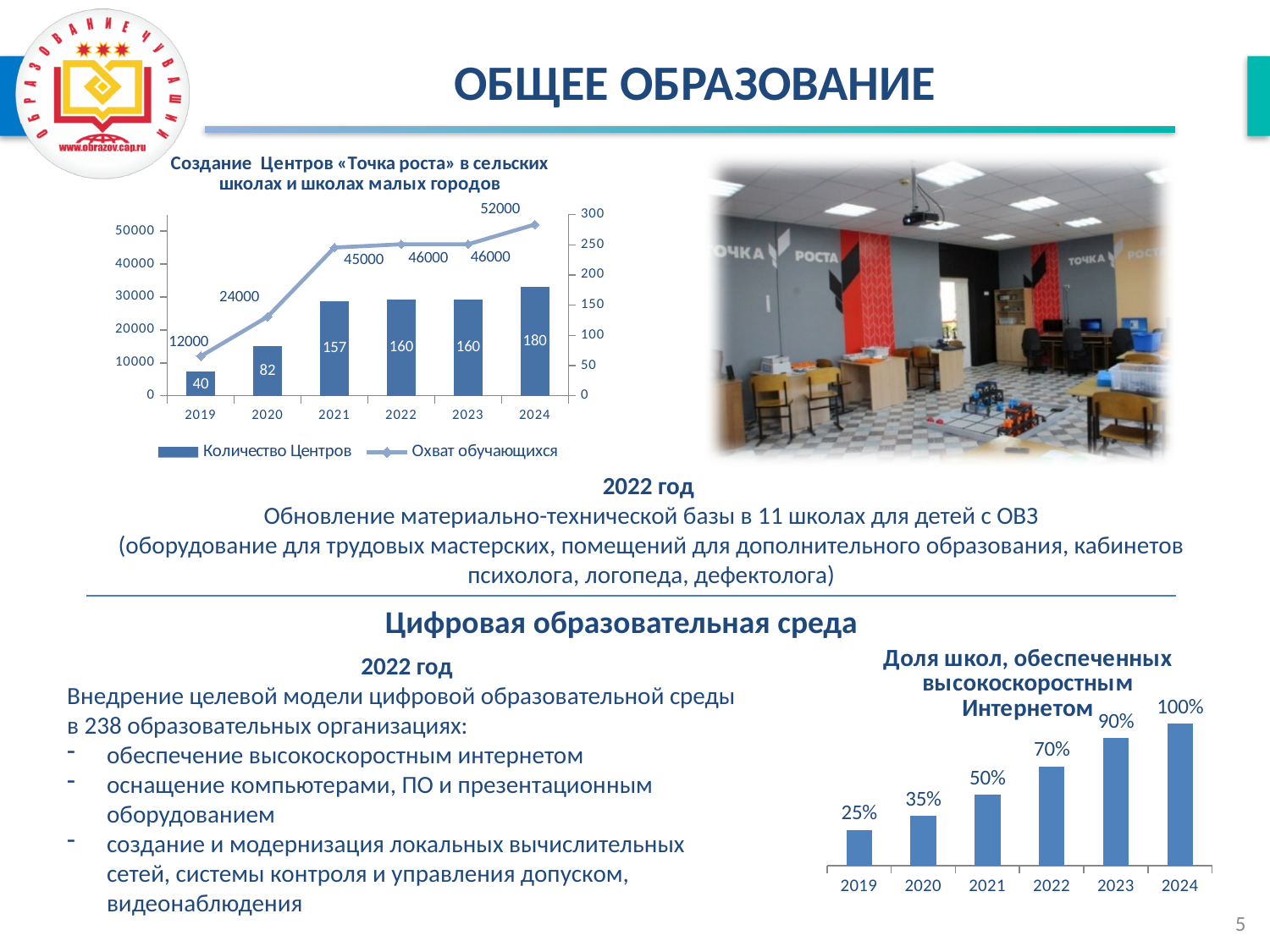
In the chart 'Создание Центров «Точка роста» в сельских школах и школах малых городов', which year has the lowest 'Охват обучающихся'? 2019 In the chart 'Создание Центров «Точка роста» в сельских школах и школах малых городов', what is the difference in 'Охват обучающихся' between 2024 and 2023? 6000 In the chart 'Доля школ, обеспеченных высокоскоростным Интернетом', what is the value for 2021? 50% In the chart 'Создание Центров «Точка роста» в сельских школах и школах малых городов', what is the value of 'Охват обучающихся' for 2020? 24000 In the chart 'Создание Центров «Точка роста» в сельских школах и школах малых городов', what is the value of 'Количество Центров' for 2021? 157 In the chart 'Доля школ, обеспеченных высокоскоростным Интернетом', which is larger, the value for 2022 or the value for 2020? 2022 In the chart 'Создание Центров «Точка роста» в сельских школах и школах малых городов', which year has the highest 'Количество Центров'? 2024 In the chart 'Создание Центров «Точка роста» в сельских школах и школах малых городов', how many years are shown on the x axis? 6 In the chart 'Создание Центров «Точка роста» в сельских школах и школах малых городов', how many series does the legend list? 2 What kind of chart is 'Доля школ, обеспеченных высокоскоростным Интернетом'? bar chart In the chart 'Создание Центров «Точка роста» в сельских школах и школах малых городов', does 'Охват обучающихся' rise or fall from 2019 to 2024? rise In the chart 'Доля школ, обеспеченных высокоскоростным Интернетом', what is the difference between the values for 2024 and 2019? 75%